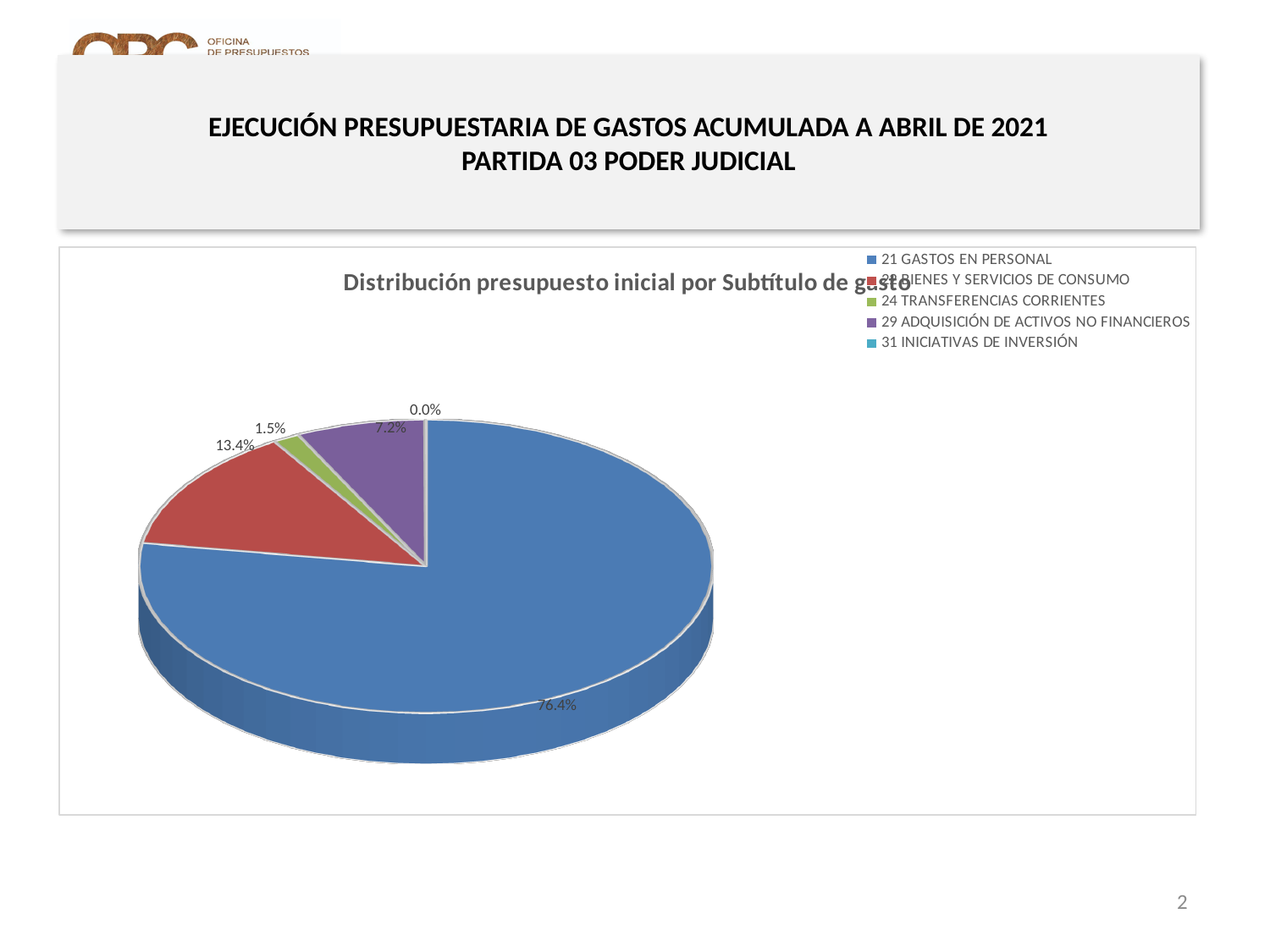
What share of the pie does 21 GASTOS EN PERSONAL represent? 76.4% What kind of chart is shown on the slide? pie chart What is the difference in percentage points between the share of 21 GASTOS EN PERSONAL and the share of BIENES Y SERVICIOS DE CONSUMO? 63.0 What share of the pie does 24 TRANSFERENCIAS CORRIENTES represent? 1.5% Which category has the largest share of the pie? 21 GASTOS EN PERSONAL What share of the pie does 31 INICIATIVAS DE INVERSIÓN represent? 0.0% What share of the pie does 29 ADQUISICIÓN DE ACTIVOS NO FINANCIEROS represent? 7.2% Which category has the smallest share of the pie? 31 INICIATIVAS DE INVERSIÓN What share of the pie does BIENES Y SERVICIOS DE CONSUMO represent? 13.4% What is the title of the chart? Distribución presupuesto inicial por Subtítulo de gasto How many categories does the legend list? 5 Which has a larger share: 29 ADQUISICIÓN DE ACTIVOS NO FINANCIEROS or 24 TRANSFERENCIAS CORRIENTES? 29 ADQUISICIÓN DE ACTIVOS NO FINANCIEROS